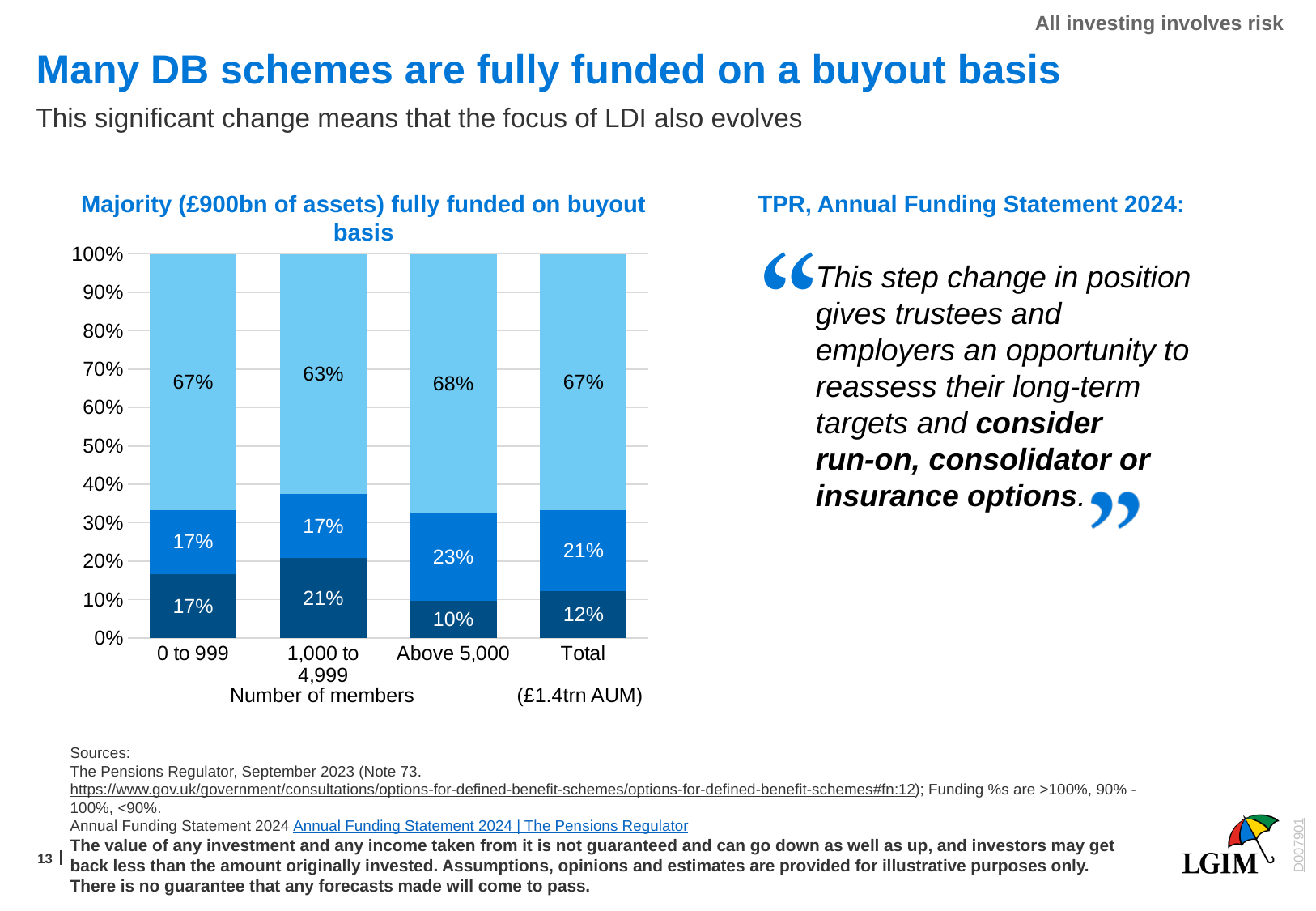
What is the total of the stacked bar for the Total category? 100% What is the title of the chart? Majority (£900bn of assets) fully funded on buyout basis What is the difference between the bottom (dark blue) segment for 1,000 to 4,999 and for Above 5,000? 11 percentage points How many categories are shown on the x axis of the chart? 4 What is the value of the bottom (dark blue) segment for the Above 5,000 category? 10% What is the value of the middle segment for the Total bar? 21% Which category has the smallest bottom (dark blue) segment? Above 5,000 Which category has the largest top (light blue) segment? Above 5,000 What is the value of the top (light blue) segment for the 1,000 to 4,999 category? 63% What is the x-axis label of the chart? Number of members Is the middle segment larger for Above 5,000 or for 0 to 999? Above 5,000 What kind of chart is shown on the slide? Stacked bar chart